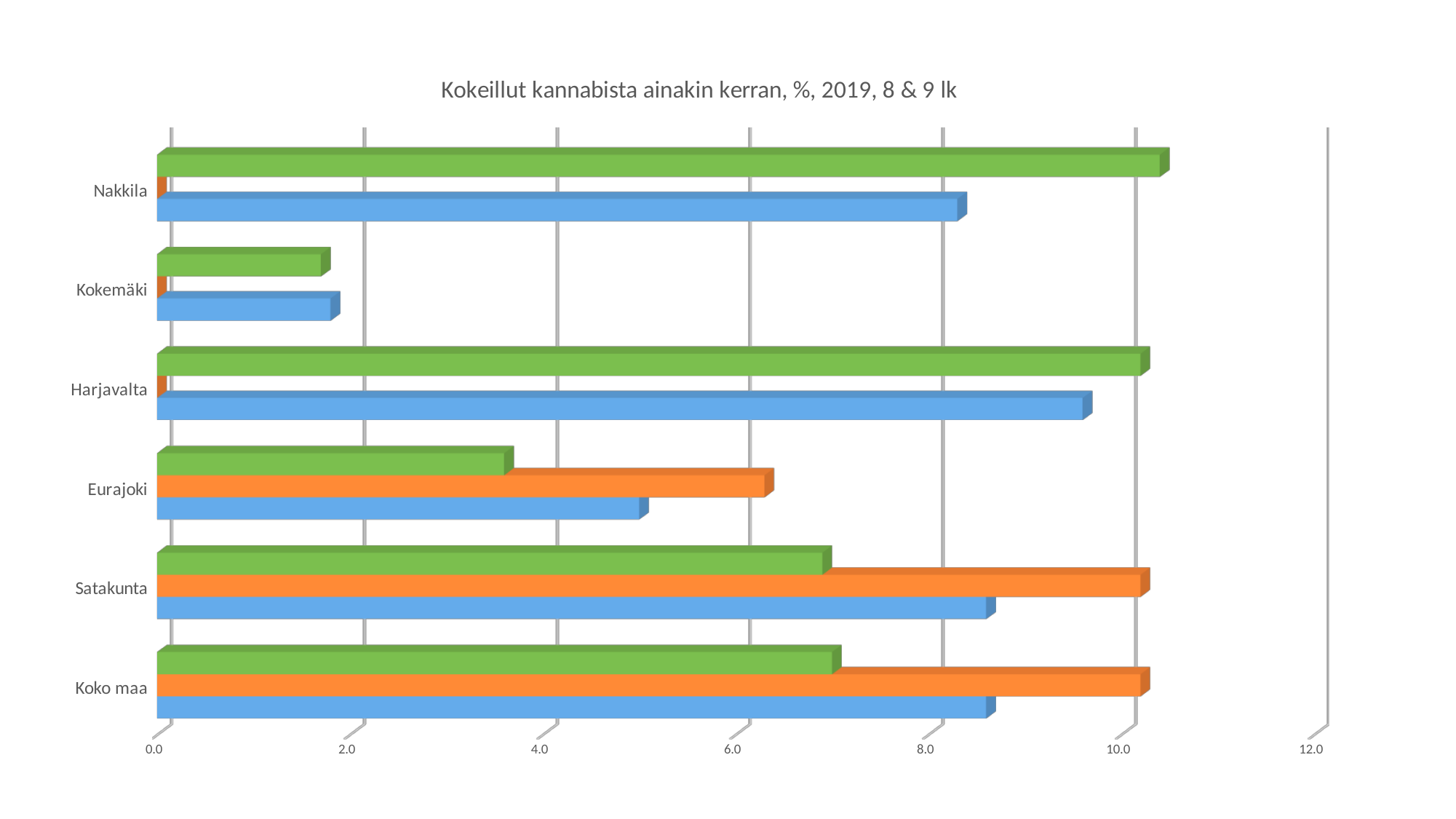
How many categories are shown on the vertical axis of the chart? 6 Is the value of the green bar for Koko maa greater or less than 8.0? less How many bars are plotted for each category in the chart? 3 Is the value of the blue bar for Harjavalta greater or less than 8.0? greater Is the value of the blue bar for Kokemäki greater or less than 2.0? less For Eurajoki, which bar is longer, the orange bar or the blue bar? orange What is the title of the chart? Kokeillut kannabista ainakin kerran, %, 2019, 8 & 9 lk What type of chart is shown on the slide? bar chart Which category has the shortest blue bar? Kokemäki For Satakunta, which bar is longer, the orange bar or the green bar? orange